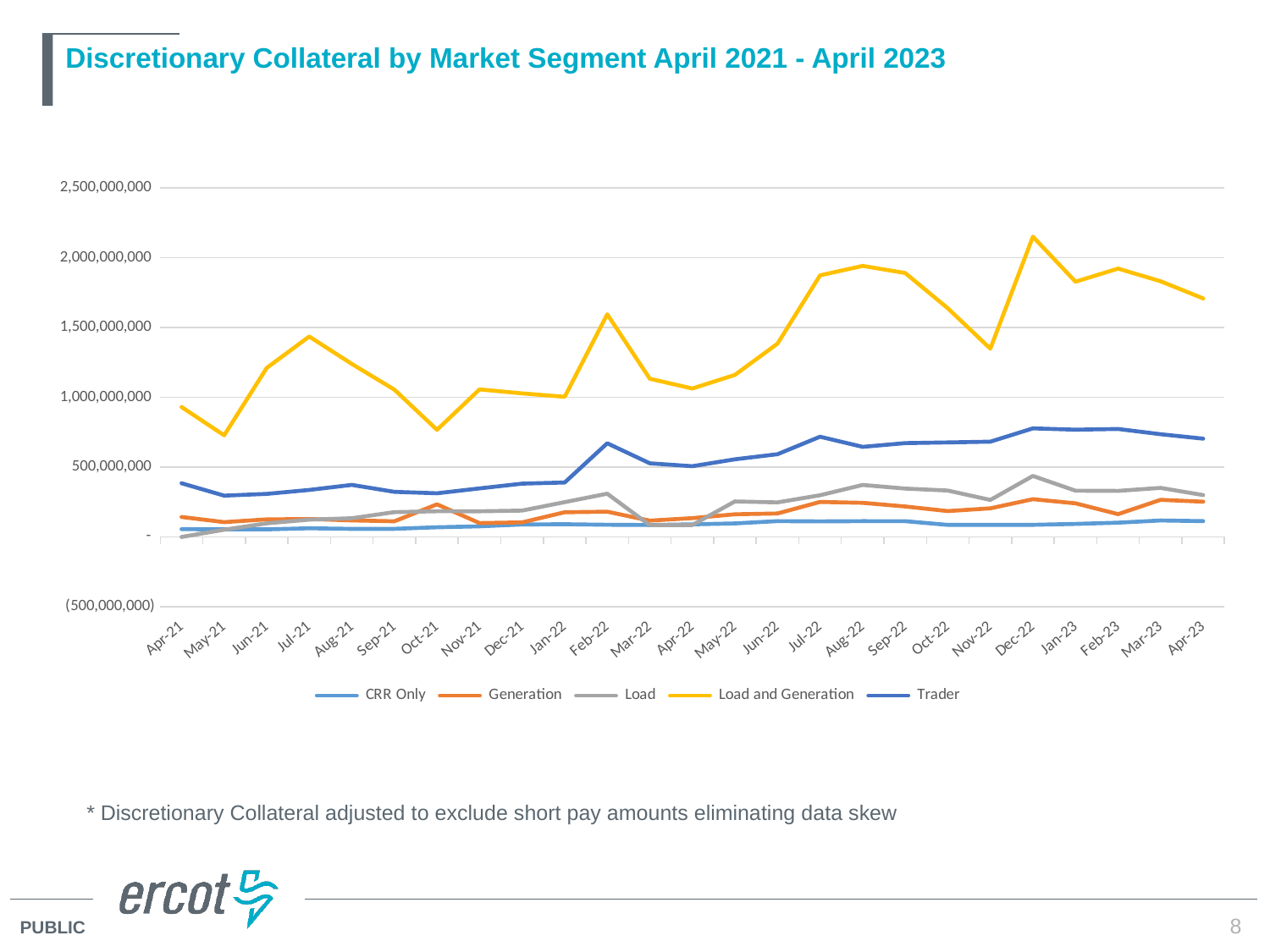
Is the value for Load and Generation in Dec-22 greater or less than 2,000,000,000? greater How many months are plotted along the x axis? 25 Which series has the highest values across the chart? Load and Generation Is the value for Trader in Apr-21 greater or less than 500,000,000? less In Feb-22, which is larger: Trader or Generation? Trader Which series has the lowest value in Apr-23? CRR Only What kind of chart is shown on the slide? line chart Is the value for Load and Generation in May-21 greater or less than 1,000,000,000? less In which month does the Load and Generation series reach its peak? Dec-22 Does the Load and Generation series rise or fall from Dec-22 to Jan-23? fall How many series does the legend list? 5